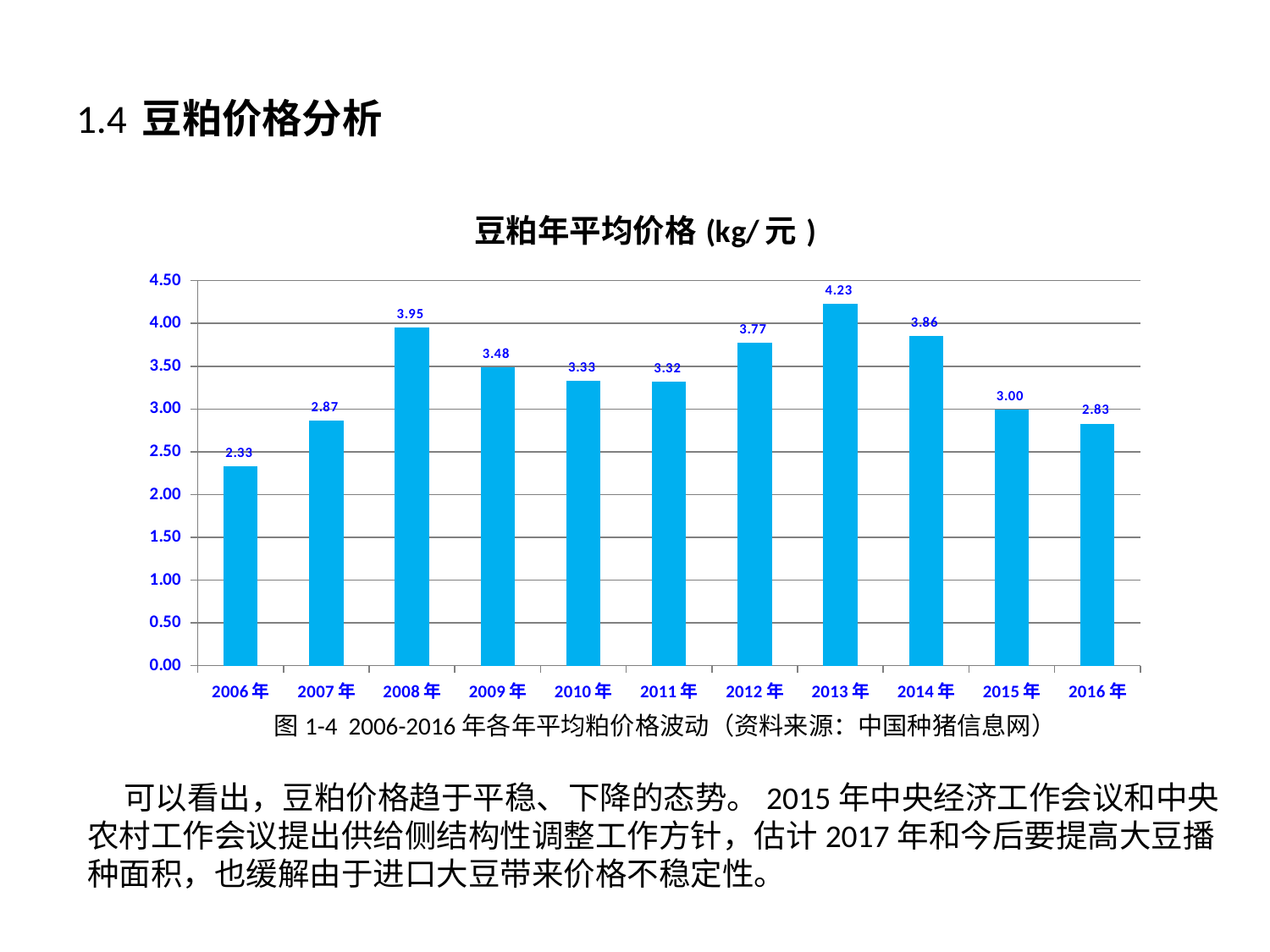
What is the difference between the values for 2013年 and 2006年? 1.90 What kind of chart is shown on the slide? bar chart Which year has the highest average soybean meal price? 2013年 How many years are shown on the x axis? 11 What is the title of the chart? 豆粕年平均价格 (kg/元) What is the average soybean meal price for 2008年? 3.95 Which is larger, the value for 2012年 or the value for 2009年? 2012年 Do the values rise or fall from 2013年 to 2016年? fall What is the value shown for 2016年? 2.83 Which year has the lowest average soybean meal price? 2006年 Is the value for 2007年 greater or less than 3.00? less What is the difference between the values for 2014年 and 2015年? 0.86